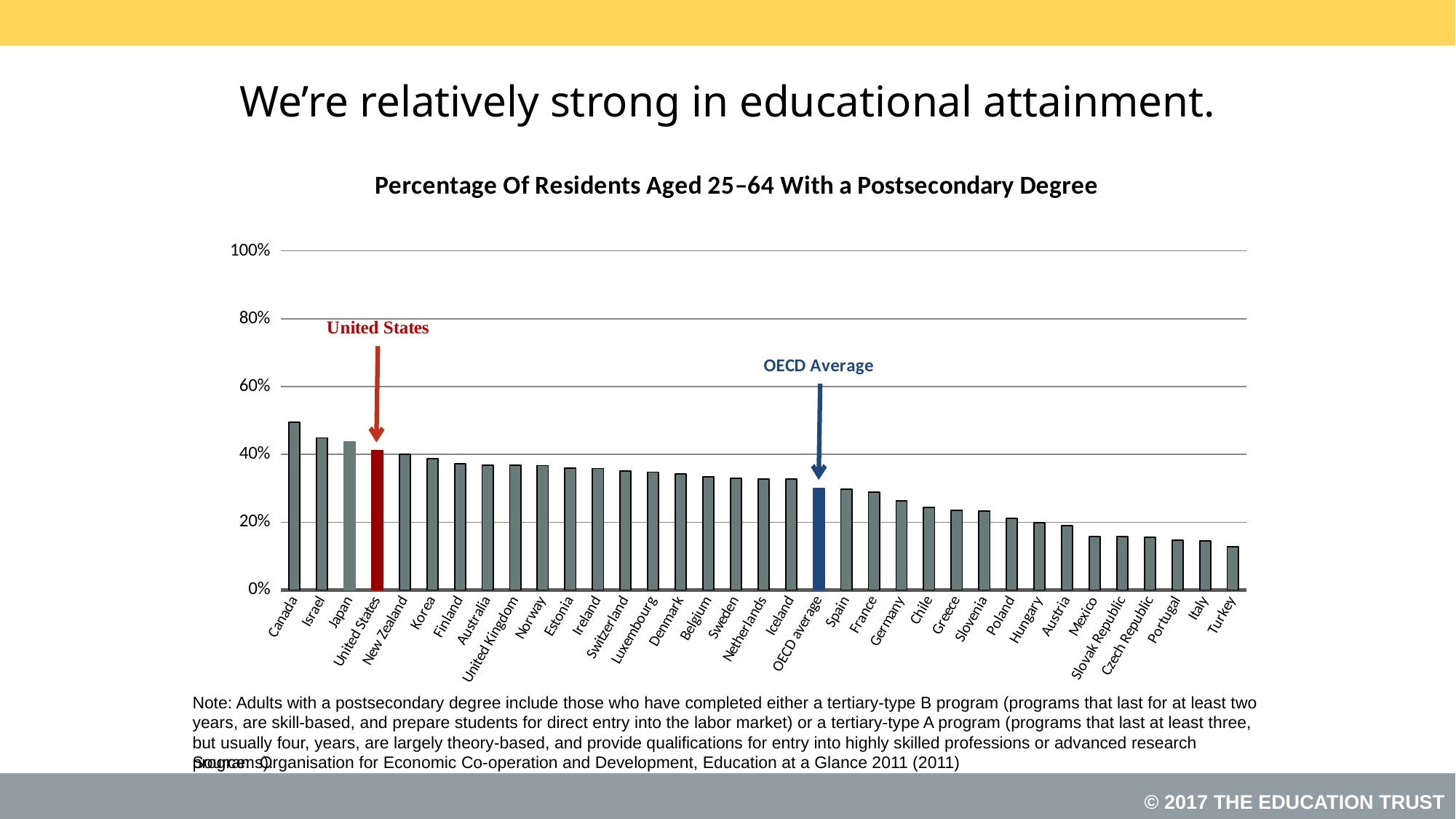
Which country has the lowest percentage of residents aged 25–64 with a postsecondary degree? Turkey Which country has the highest percentage of residents aged 25–64 with a postsecondary degree? Canada Is the value for the OECD average greater or less than 40%? less What kind of chart is shown on the slide? bar chart Is the value for Spain greater or less than 20%? greater Which has a higher value, the United States or the OECD average? United States Is the value for Mexico greater or less than 20%? less Which has a higher value, Germany or Poland? Germany What is the title of the chart? Percentage Of Residents Aged 25–64 With a Postsecondary Degree Do the values rise or fall moving from left to right along the x axis? fall